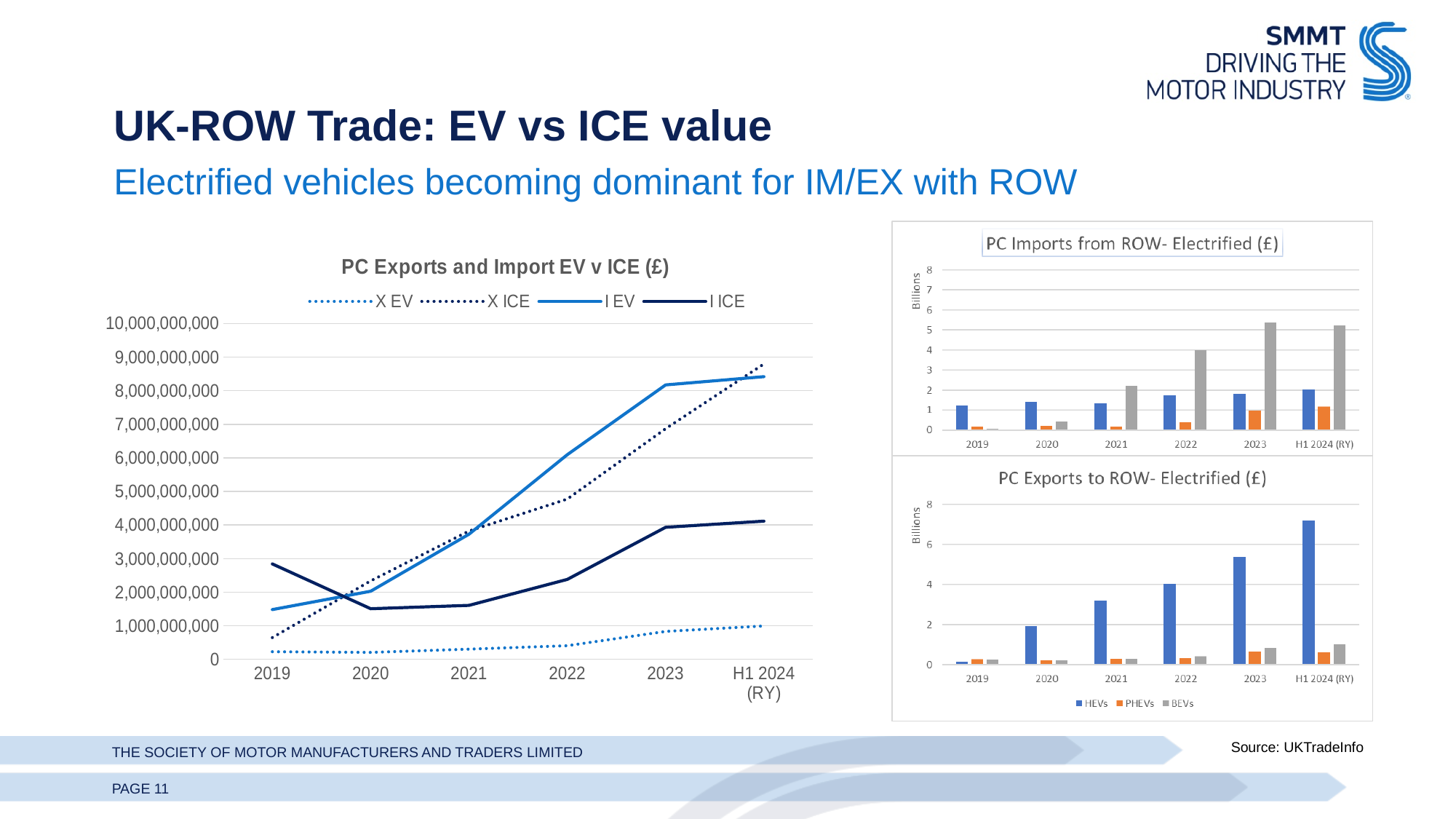
In 'PC Imports from ROW- Electrified (£)', is the value for BEVs in 2023 greater or less than 4? greater How many series does the legend of 'PC Exports to ROW- Electrified (£)' list? 3 How many series does the legend of 'PC Exports and Import EV v ICE (£)' list? 4 How many time periods are shown on the x axis of 'PC Exports and Import EV v ICE (£)'? 6 In 'PC Exports and Import EV v ICE (£)', does the X ICE series rise or fall from 2019 to H1 2024 (RY)? rise In 'PC Exports and Import EV v ICE (£)', which is larger in 2019: I ICE or I EV? I ICE What kind of chart is 'PC Exports and Import EV v ICE (£)'? line chart In 'PC Exports and Import EV v ICE (£)', is the value for I EV in 2023 greater or less than 7,000,000,000? greater In 'PC Exports to ROW- Electrified (£)', is the value for HEVs in H1 2024 (RY) greater or less than 6? greater In 'PC Exports and Import EV v ICE (£)', which series has the lowest value in H1 2024 (RY)? X EV In 'PC Imports from ROW- Electrified (£)', which series has the highest value in 2023? BEVs